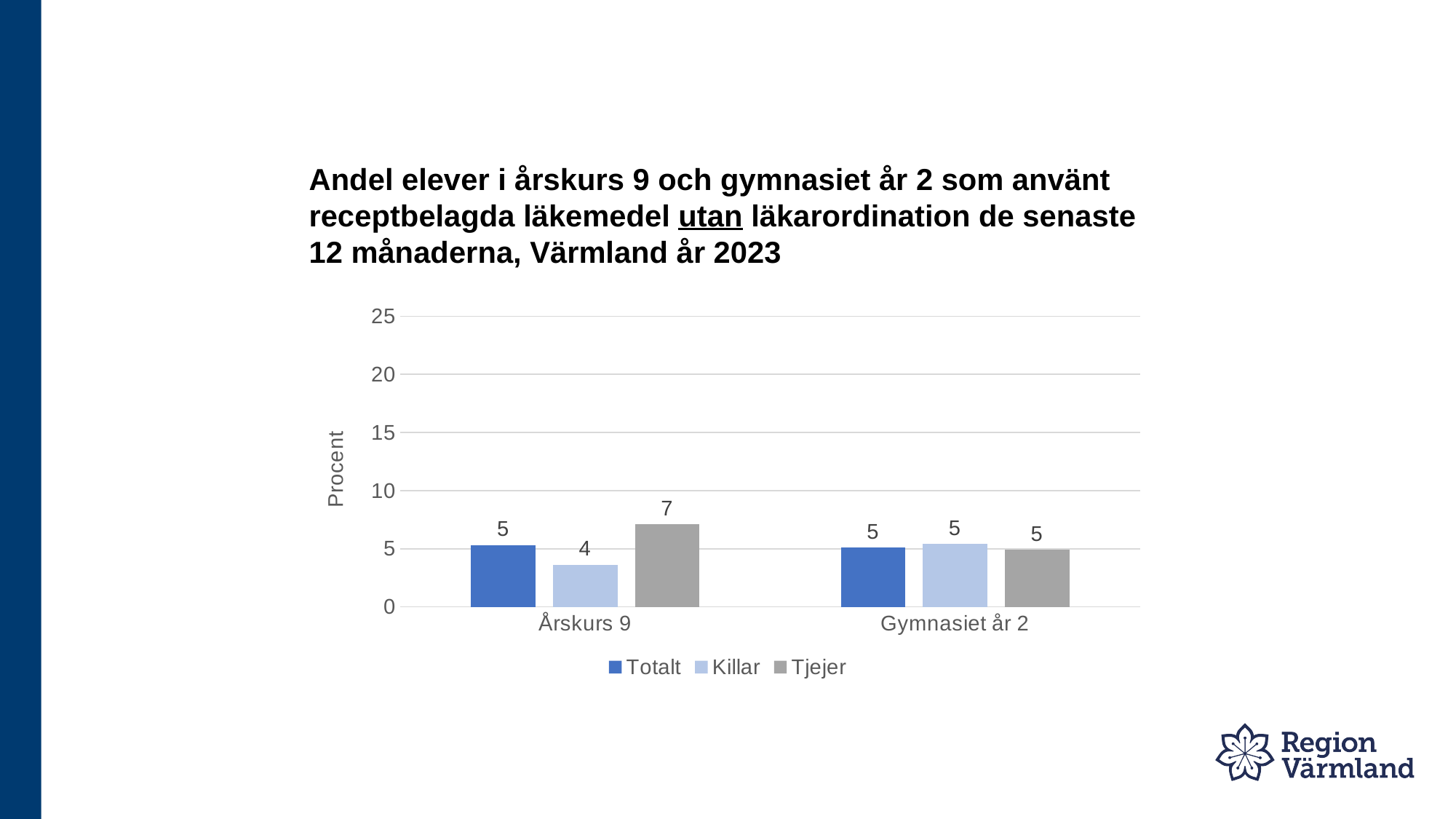
How many series does the legend list? 3 Which series has the lowest value in Årskurs 9? Killar What is the value for Totalt in Gymnasiet år 2? 5 Is the value for Tjejer in Årskurs 9 greater or less than 5? greater How many categories are shown on the x axis? 2 In Årskurs 9, which is larger: the value for Tjejer or the value for Killar? Tjejer What is the value for Killar in Gymnasiet år 2? 5 What is the difference between the Tjejer and Killar values in Årskurs 9? 3 What is the value for Killar in Årskurs 9? 4 What kind of chart is shown on the slide? Bar chart Which series has the highest value in Årskurs 9? Tjejer What is the value for Tjejer in Årskurs 9? 7